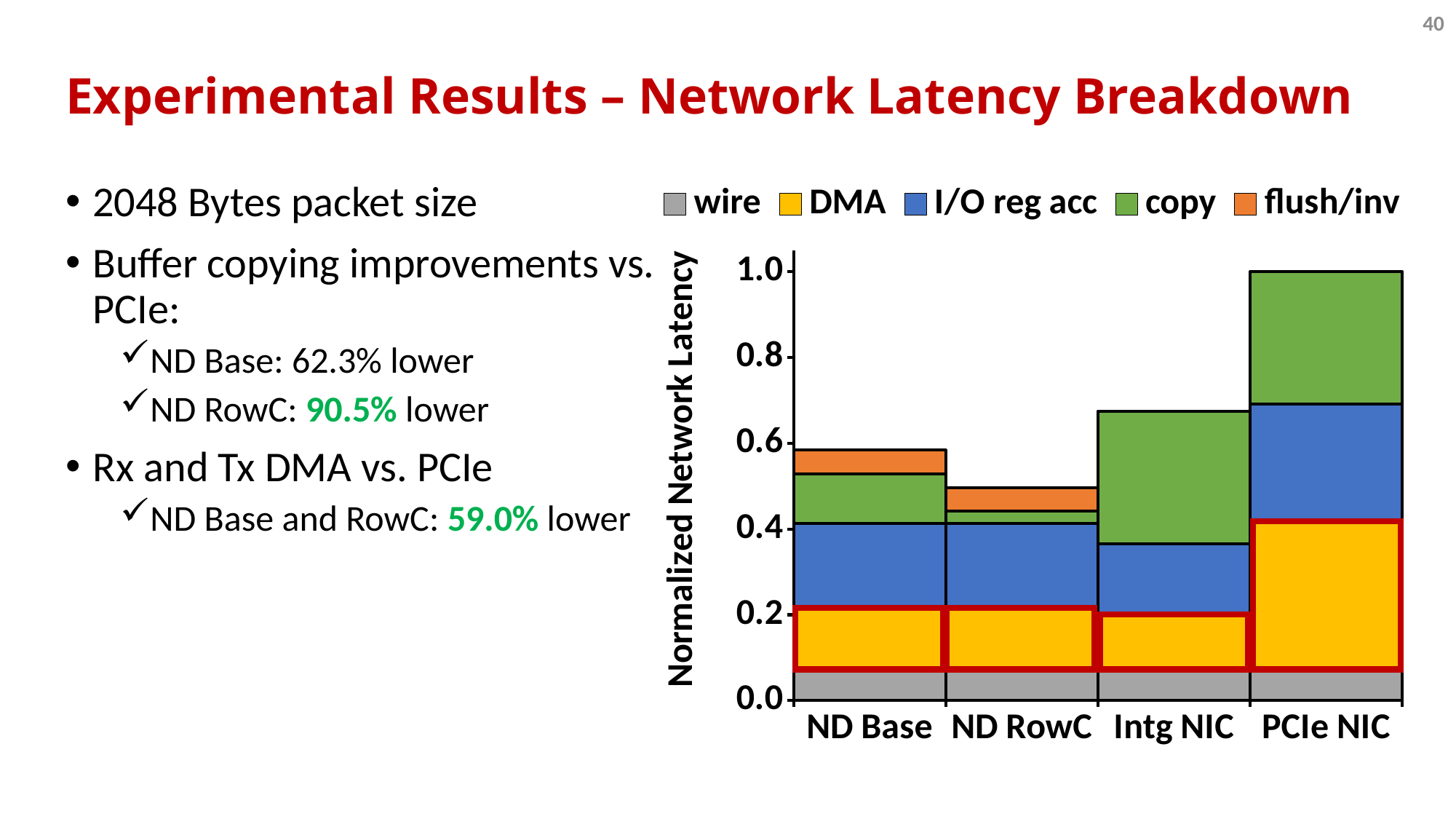
Which category has the highest total normalized network latency? PCIe NIC How many categories are shown on the x axis of the chart? 4 Which series is shown at the bottom of each stacked bar? wire What kind of chart is shown on the slide? Stacked bar chart Which category has the largest DMA segment? PCIe NIC What is the label of the y axis of the chart? Normalized Network Latency Which has a larger total normalized network latency, Intg NIC or ND Base? Intg NIC What is the total normalized network latency of the PCIe NIC bar? 1.0 Which category has the lowest total normalized network latency? ND RowC Is the total normalized network latency for Intg NIC greater or less than 0.6? greater How many series does the chart legend list? 5 Is the total normalized network latency for ND Base greater or less than 0.8? less